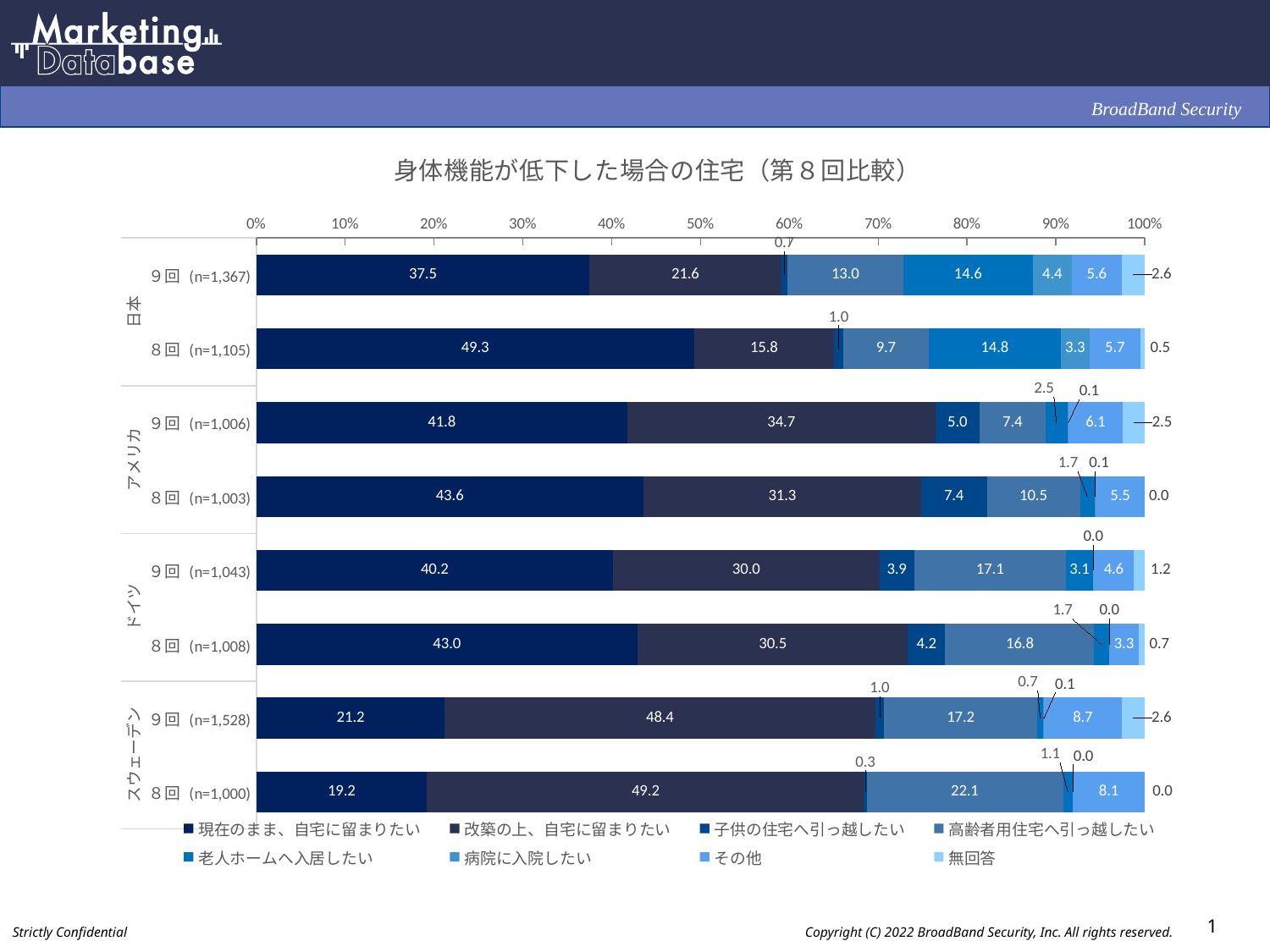
What type of chart is shown on the slide? Stacked bar chart Which bar has the highest value for 現在のまま、自宅に留まりたい? 日本 8回 (n=1,105) How many series does the legend list? 8 How many bars (survey rows) are plotted in the chart? 8 What is the title of the chart? 身体機能が低下した場合の住宅（第８回比較） Which is larger: 改築の上、自宅に留まりたい for アメリカ 9回 (n=1,006) or for アメリカ 8回 (n=1,003)? アメリカ 9回 (n=1,006) What is the value of 高齢者用住宅へ引っ越したい for ドイツ 9回 (n=1,043)? 17.1 Is the value of 改築の上、自宅に留まりたい for スウェーデン 9回 (n=1,528) greater or less than 40? greater What is the difference in 現在のまま、自宅に留まりたい between 日本 8回 (n=1,105) and 日本 9回 (n=1,367)? 11.8 What is the value of 現在のまま、自宅に留まりたい for 日本 9回 (n=1,367)? 37.5 What is the value of 改築の上、自宅に留まりたい for スウェーデン 8回 (n=1,000)? 49.2 Which bar has the lowest value for 現在のまま、自宅に留まりたい? スウェーデン 8回 (n=1,000)